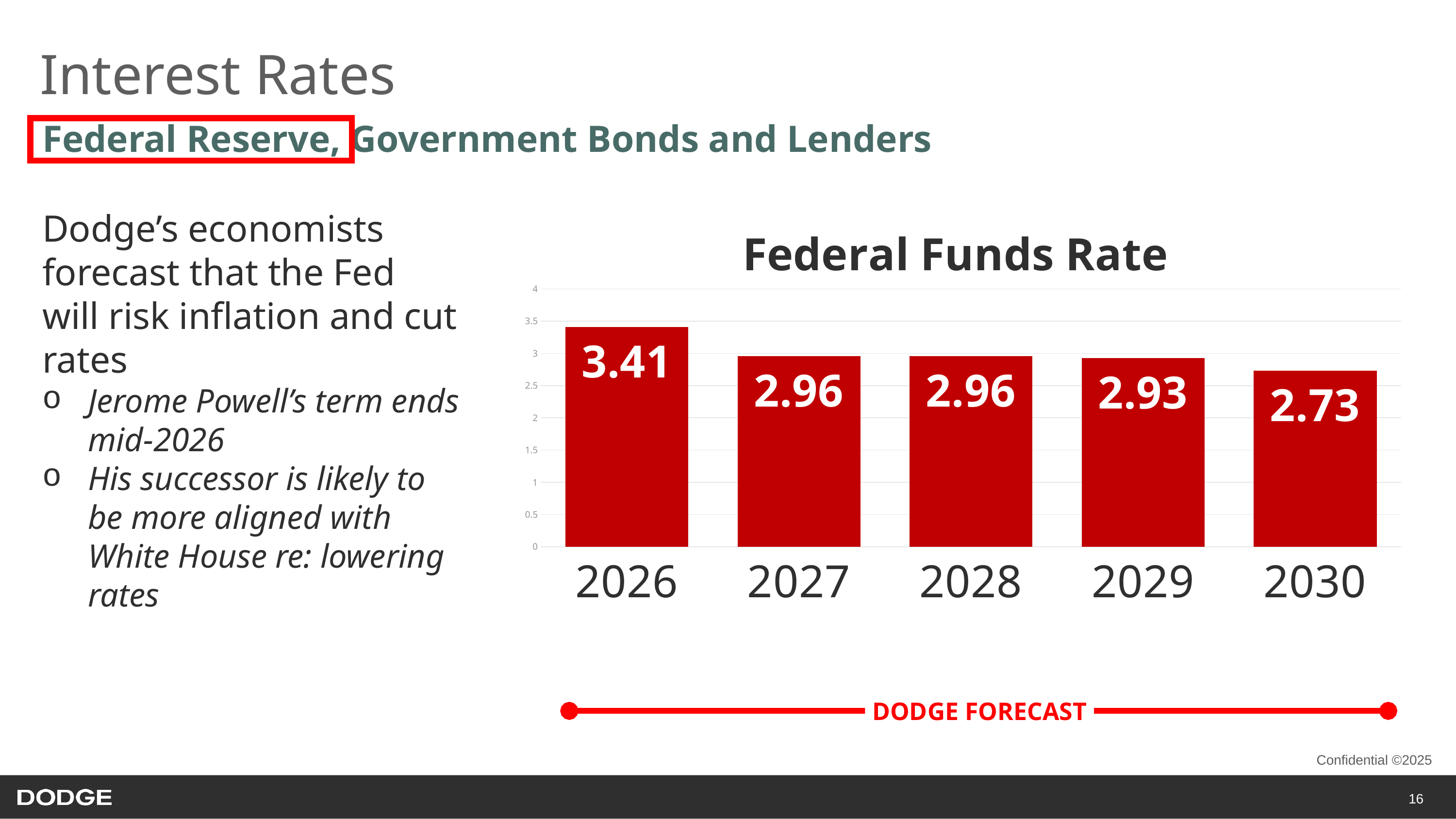
What is the Federal Funds Rate value shown for 2030? 2.73 Which year has the highest Federal Funds Rate in the chart? 2026 What is the Federal Funds Rate value shown for 2029? 2.93 What is the Federal Funds Rate value shown for 2026? 3.41 What is the difference between the Federal Funds Rate for 2026 and 2030? 0.68 Which is larger, the Federal Funds Rate for 2026 or for 2027? 2026 What is the difference between the Federal Funds Rate for 2027 and 2029? 0.03 What kind of chart is the Federal Funds Rate chart? bar chart Which year has the lowest Federal Funds Rate in the chart? 2030 How many years are shown in the Federal Funds Rate chart? 5 Do the Federal Funds Rate values generally rise or fall from 2026 to 2030? fall Is the Federal Funds Rate for 2030 greater or less than 3? less